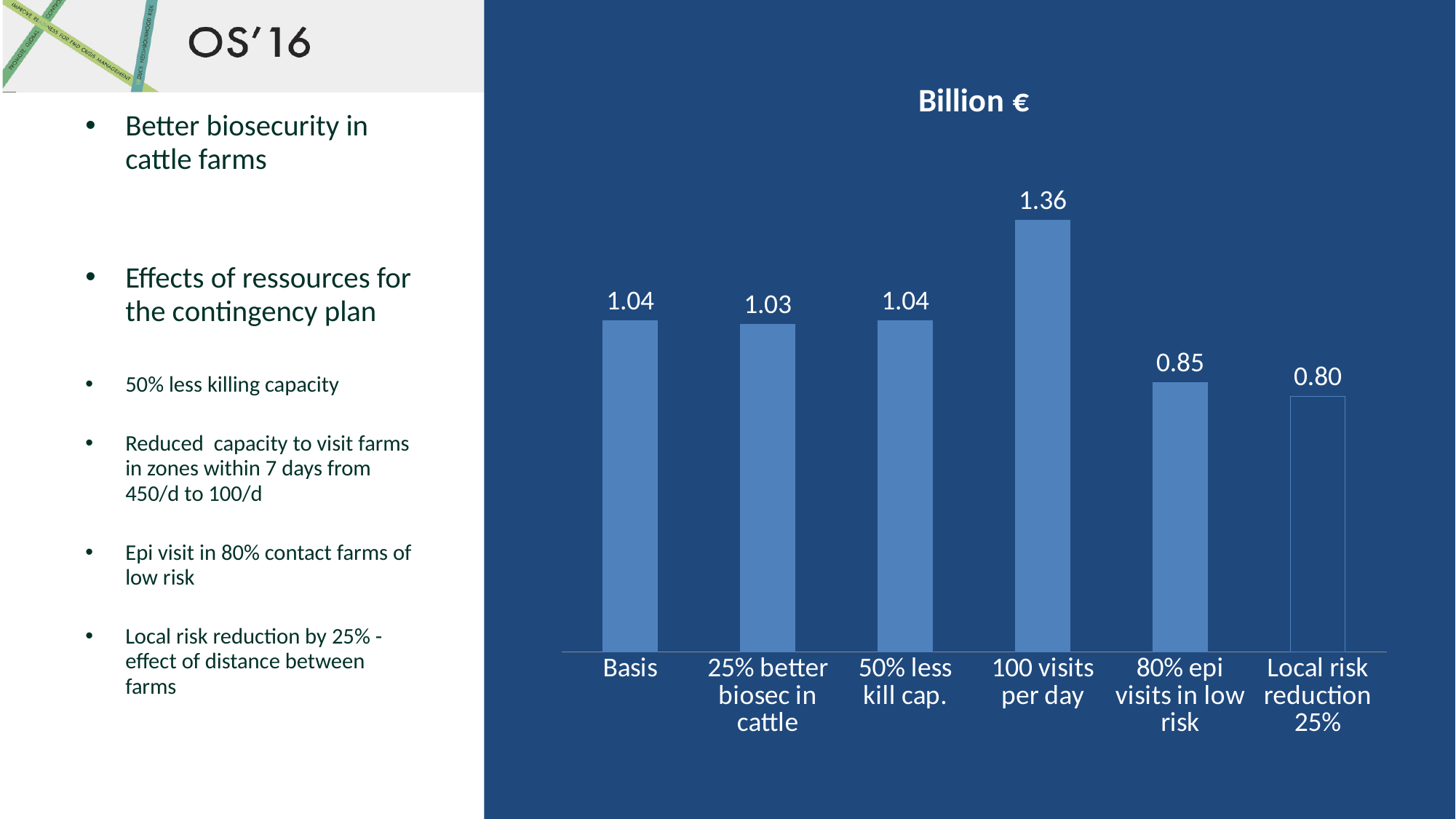
What is the value for Basis? 1.04 What is the value for Local risk reduction 25%? 0.80 Which category has the highest value? 100 visits per day What is the value for 80% epi visits in low risk? 0.85 What is the value for 100 visits per day? 1.36 What kind of chart is shown on the slide? Bar chart What is the difference between the values for 100 visits per day and Basis? 0.32 What is the difference between the values for Basis and 25% better biosec in cattle? 0.01 Which category has the lowest value? Local risk reduction 25% Which is larger, the value for 80% epi visits in low risk or the value for Local risk reduction 25%? 80% epi visits in low risk How many categories are shown in the chart? 6 What is the title of the chart? Billion €